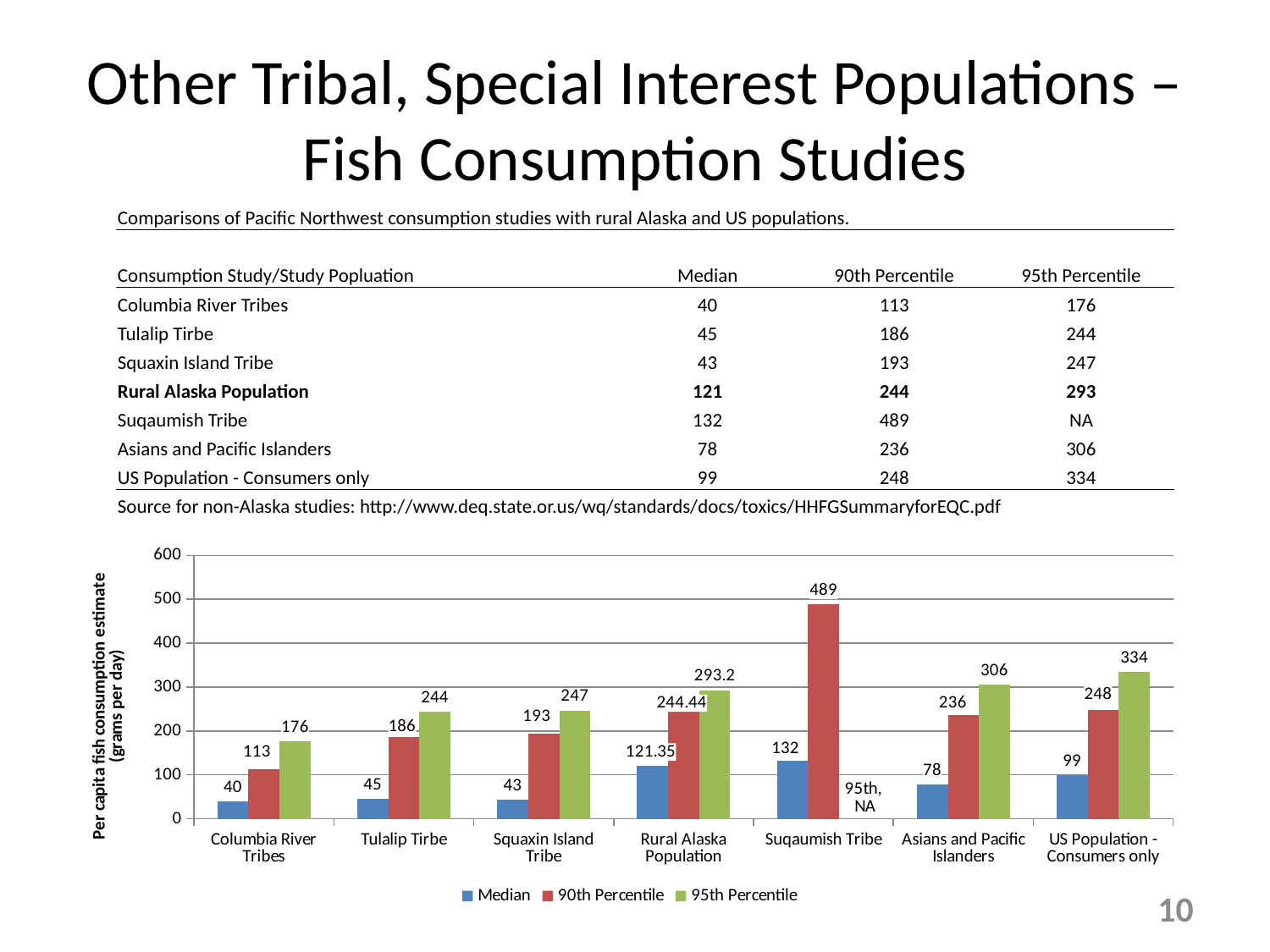
Which study population has the lowest Median value in the chart? Columbia River Tribes How many series does the chart legend list? 3 Is the 90th Percentile value for the Suqaumish Tribe greater or less than 400? greater In the chart, what is the 90th Percentile value for the Suqaumish Tribe? 489 In the chart, which is larger: the 90th Percentile value for Asians and Pacific Islanders or for US Population - Consumers only? US Population - Consumers only In the chart, what is the 95th Percentile value for US Population - Consumers only? 334 What type of chart is shown on the slide? bar chart Which study population has the highest 90th Percentile value in the chart? Suqaumish Tribe What is the label on the chart's y axis? Per capita fish consumption estimate (grams per day) In the chart, what is the Median value for the Rural Alaska Population? 121.35 How many study populations are shown along the x axis of the chart? 7 In the chart, what is the difference between the 95th Percentile and Median values for the Tulalip Tirbe? 199